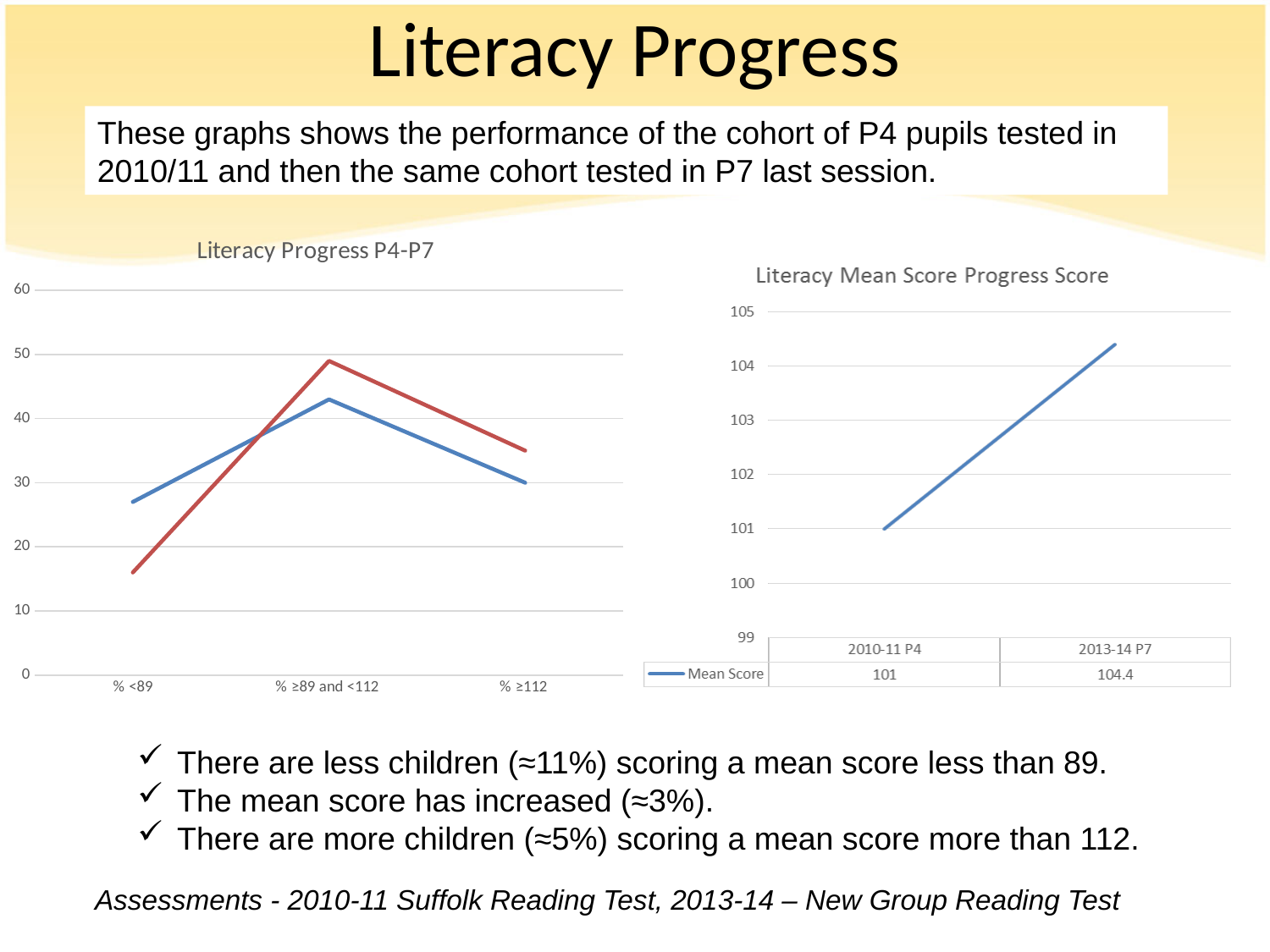
In the Literacy Progress P4-P7 chart, which category has the highest value on the red line? % ≥89 and <112 How many series does the legend of the Literacy Mean Score Progress Score chart list? 1 In the Literacy Mean Score Progress Score chart, does the Mean Score rise or fall from 2010-11 P4 to 2013-14 P7? rise How many categories are shown on the x axis of the Literacy Progress P4-P7 chart? 3 In the Literacy Mean Score Progress Score chart, what is the Mean Score for 2013-14 P7? 104.4 In the Literacy Progress P4-P7 chart, is the value of the red line for "% <89" greater or less than 20? less In the Literacy Progress P4-P7 chart, is the value of the red line for "% ≥89 and <112" greater or less than 40? greater What kind of chart is the Literacy Mean Score Progress Score chart? line chart In the Literacy Mean Score Progress Score chart, by how much did the Mean Score increase from 2010-11 P4 to 2013-14 P7? 3.4 In the Literacy Progress P4-P7 chart, at "% <89", which line has the larger value, the blue line or the red line? the blue line What is the title of the chart on the left of the slide? Literacy Progress P4-P7 In the Literacy Mean Score Progress Score chart, what is the Mean Score for 2010-11 P4? 101